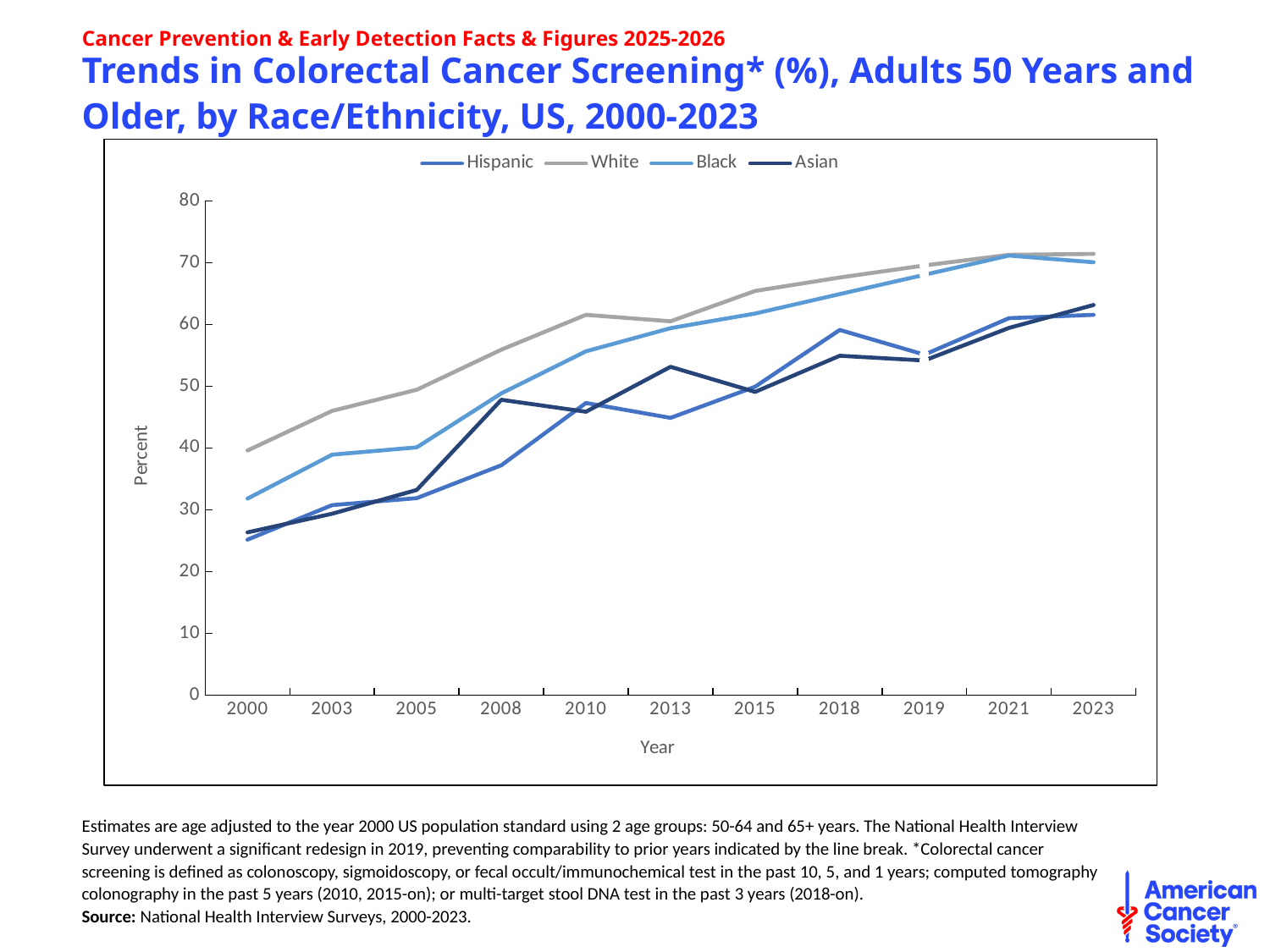
Which group has the highest screening percentage in 2015? White How many series does the legend list? 4 In 2010, which is larger, the value for Black or the value for Hispanic? Black Is the value for Hispanic in 2000 greater or less than 30? less What kind of chart is shown on the slide? Line chart Is the value for White in 2023 greater or less than 70? greater Does the White series generally rise or fall from 2000 to 2023? Rise Which race/ethnicity group has the lowest screening percentage in 2013? Hispanic What is the label of the y axis? Percent Which race/ethnicity group has the highest screening percentage in 2000? White How many years are shown on the x axis? 11 Is the value for Asian in 2023 greater or less than 60? greater